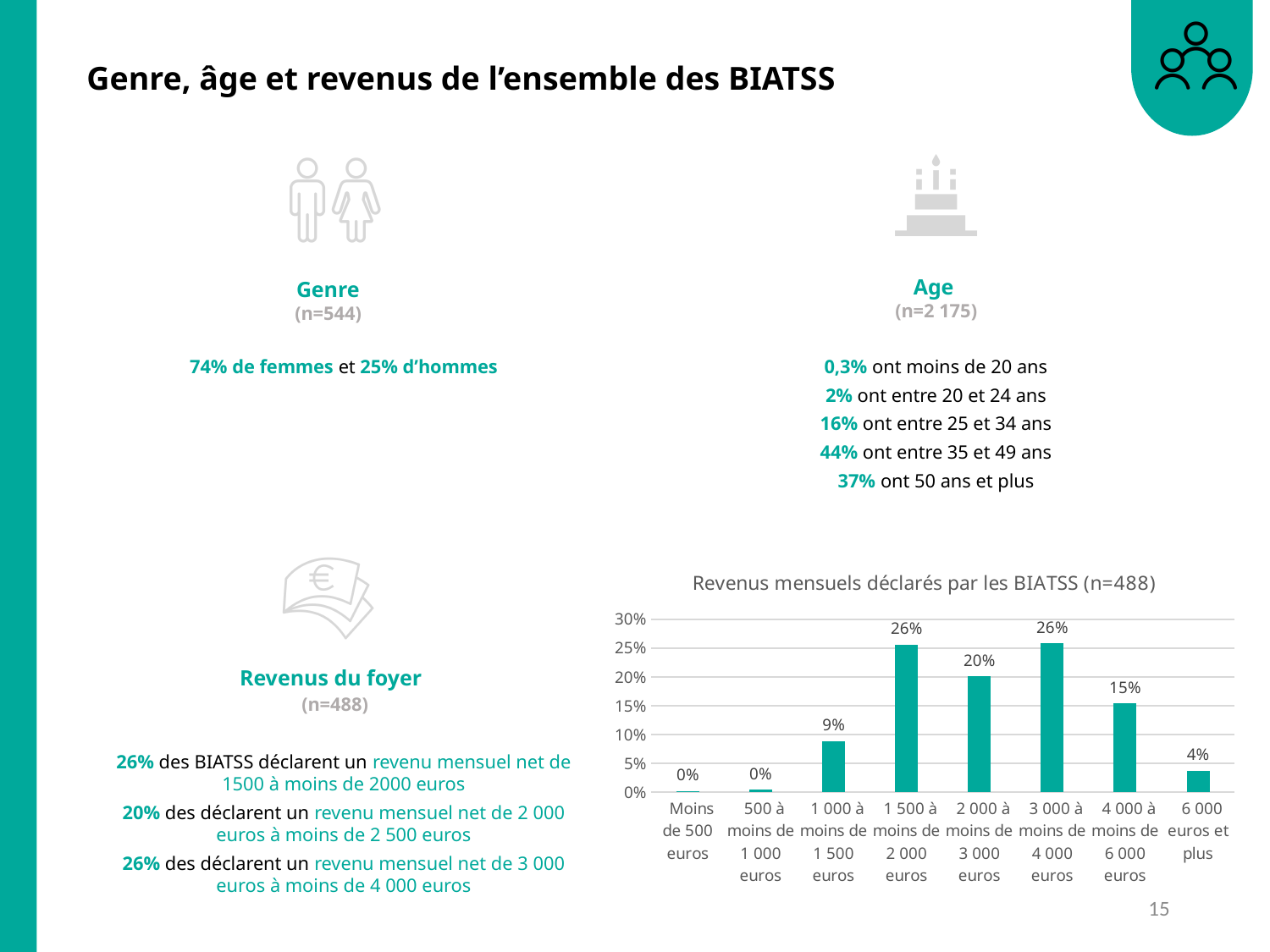
What is the difference between the values for '1 500 à moins de 2 000 euros' and '2 000 à moins de 3 000 euros'? 6% What is the title of the chart on the slide? Revenus mensuels déclarés par les BIATSS (n=488) What kind of chart is shown on the slide? Bar chart What is the value for the category '6 000 euros et plus'? 4% What is the highest value shown in the chart? 26% What is the value for the category '4 000 à moins de 6 000 euros'? 15% What is the value for the category 'Moins de 500 euros'? 0% Which is larger: the value for '4 000 à moins de 6 000 euros' or the value for '6 000 euros et plus'? 4 000 à moins de 6 000 euros What is the value for the category '1 000 à moins de 1 500 euros'? 9% What is the difference between the values for '3 000 à moins de 4 000 euros' and '4 000 à moins de 6 000 euros'? 11% How many income categories are shown on the x axis of the chart? 8 What is the value for the category '2 000 à moins de 3 000 euros'? 20%